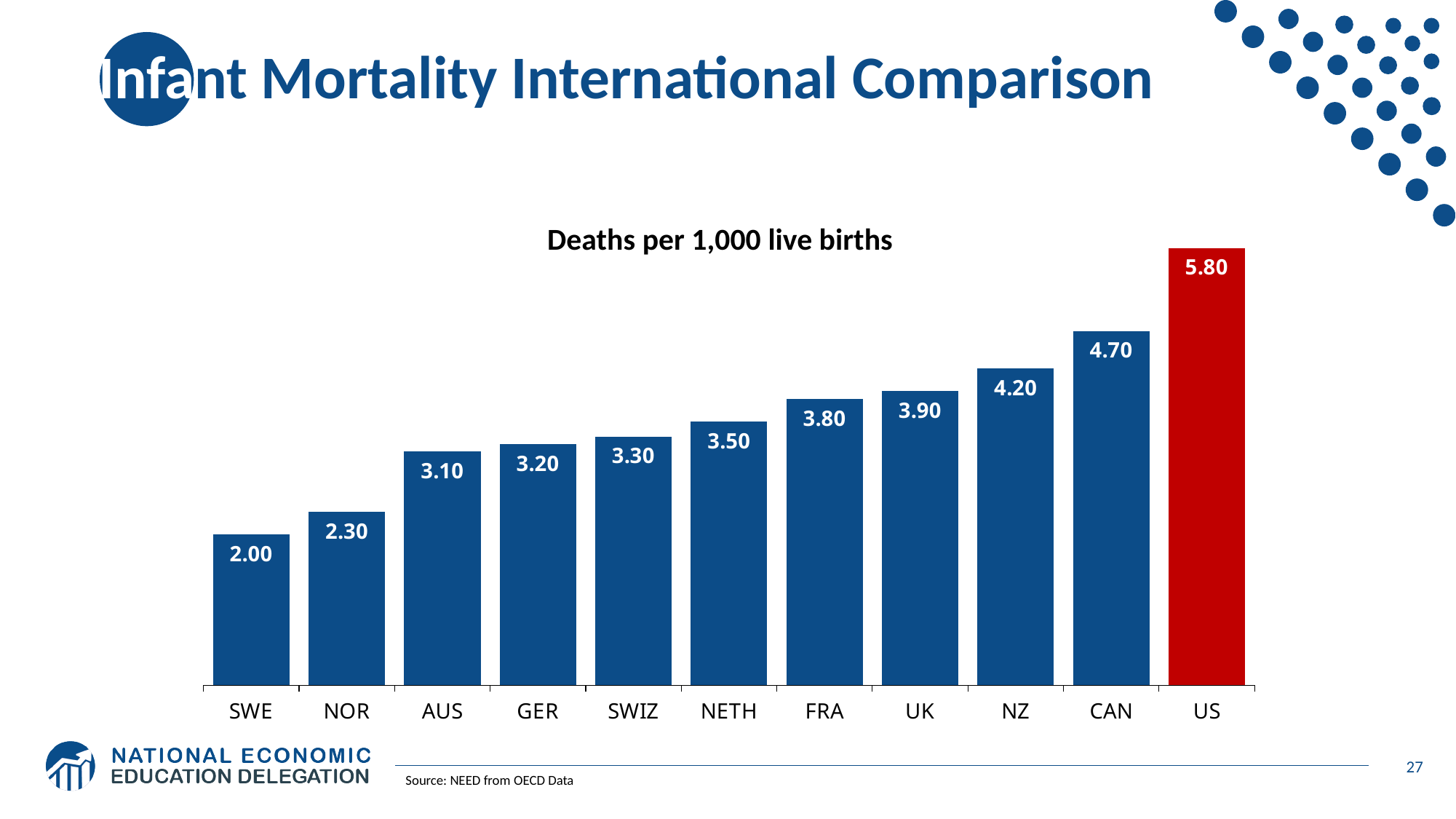
What is the title of the chart? Deaths per 1,000 live births What kind of chart is this? Bar chart What is the difference between the values for NZ and SWE? 2.20 Which country has the highest value? US Do the values rise or fall from left to right along the x axis? Rise Which has a larger value, FRA or UK? UK What is the value for GER? 3.20 What is the difference between the values for the US and CAN? 1.10 How many countries are shown on the chart? 11 What is the value for NETH? 3.50 Which country has the lowest value? SWE What is the value for the US? 5.80